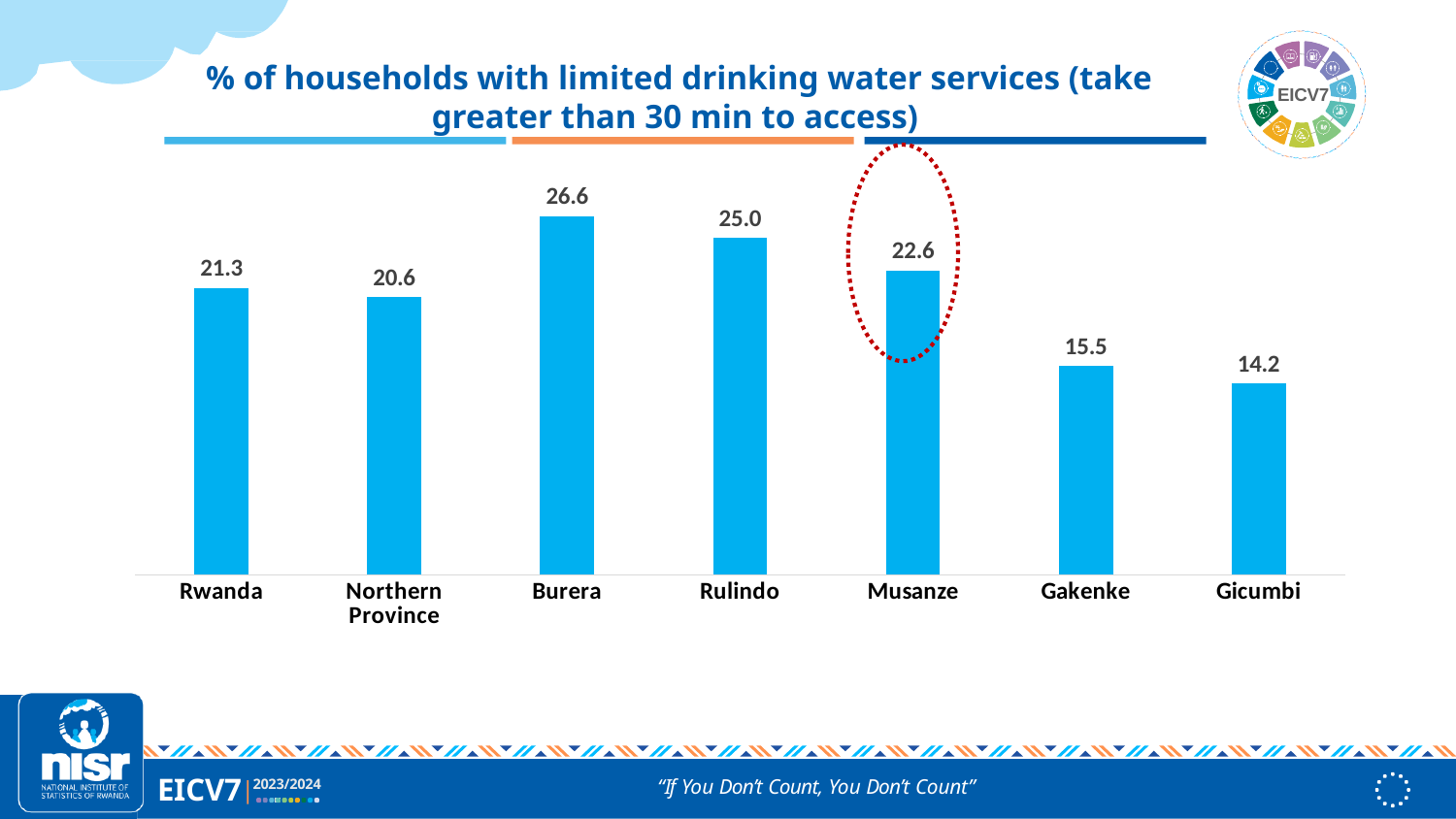
What is the value for Northern Province? 20.6 Which is larger, the value for Rulindo or the value for Gakenke? Rulindo What is the value for Musanze? 22.6 What is the difference between the values for Burera and Gicumbi? 12.4 What kind of chart is shown on the slide? Bar chart Which category has the highest value? Burera How many categories are shown on the x axis? 7 What is the value for Gicumbi? 14.2 What is the difference between the values for Rwanda and Northern Province? 0.7 What is the value for Burera? 26.6 Which category has the lowest value? Gicumbi Which category is highlighted with a red dotted circle? Musanze